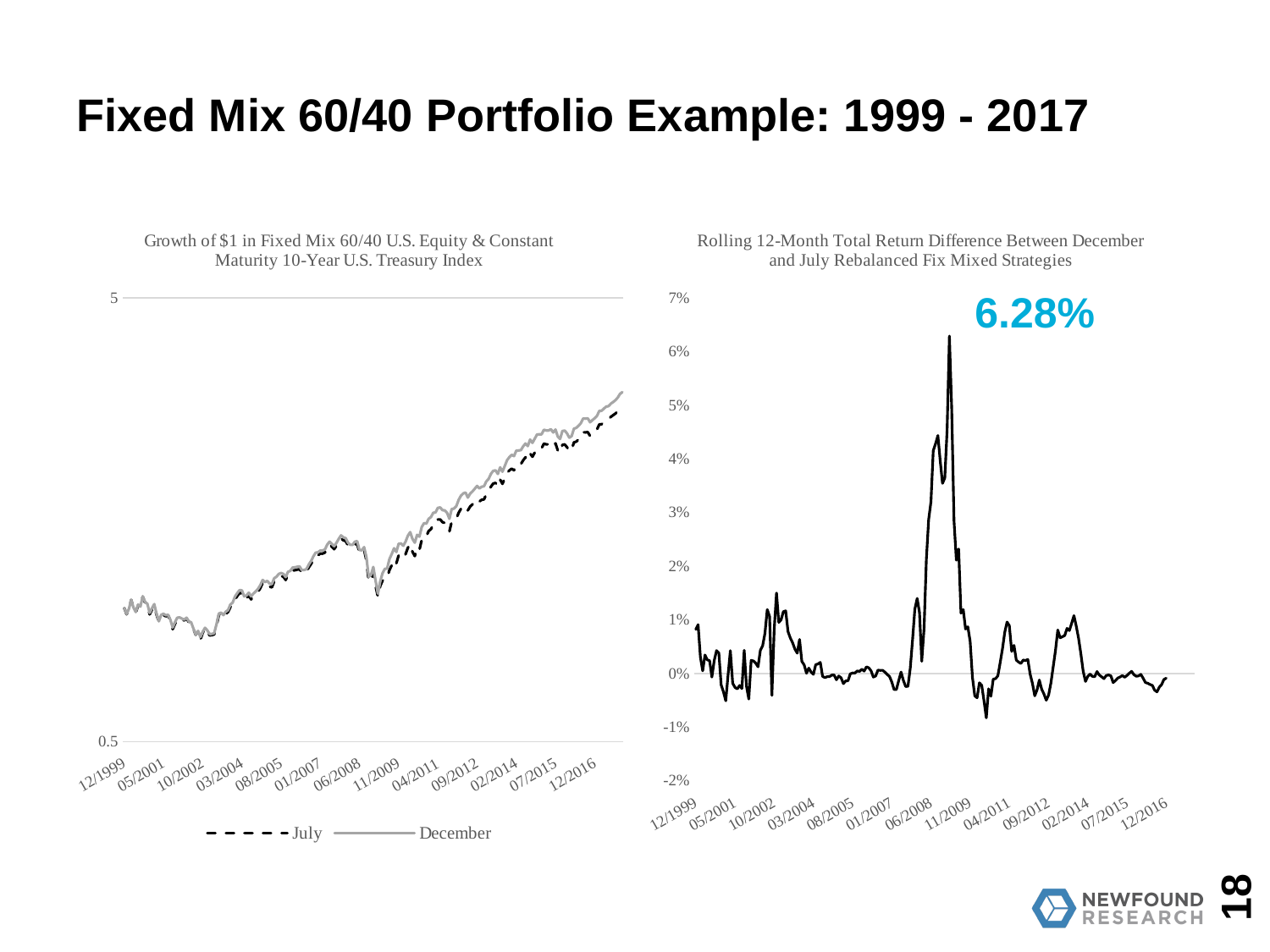
What kind of chart is the left chart titled 'Growth of $1 in Fixed Mix 60/40 U.S. Equity & Constant Maturity 10-Year U.S. Treasury Index'? Line chart How many series does the legend of the left chart list? 2 In the right chart, what is the peak value annotated on the chart? 6.28% What kind of chart is the right chart titled 'Rolling 12-Month Total Return Difference Between December and July Rebalanced Fix Mixed Strategies'? Line chart In the right chart, is the peak around 11/2009 higher or lower than the peak around 10/2002? Higher In the left chart, do the series generally rise or fall from 11/2009 to 12/2016? Rise In the left chart, is the value of the December series at 12/2016 greater or less than 5? less In the right chart, is the peak value reached around 11/2009 greater or less than 6%? greater How many date labels are shown on the x axis of the right chart? 13 What are the two series named in the legend of the left chart? July and December In the left chart, at 12/2016, which series is higher, July or December? December In the left chart, which series is drawn with a dashed line? July